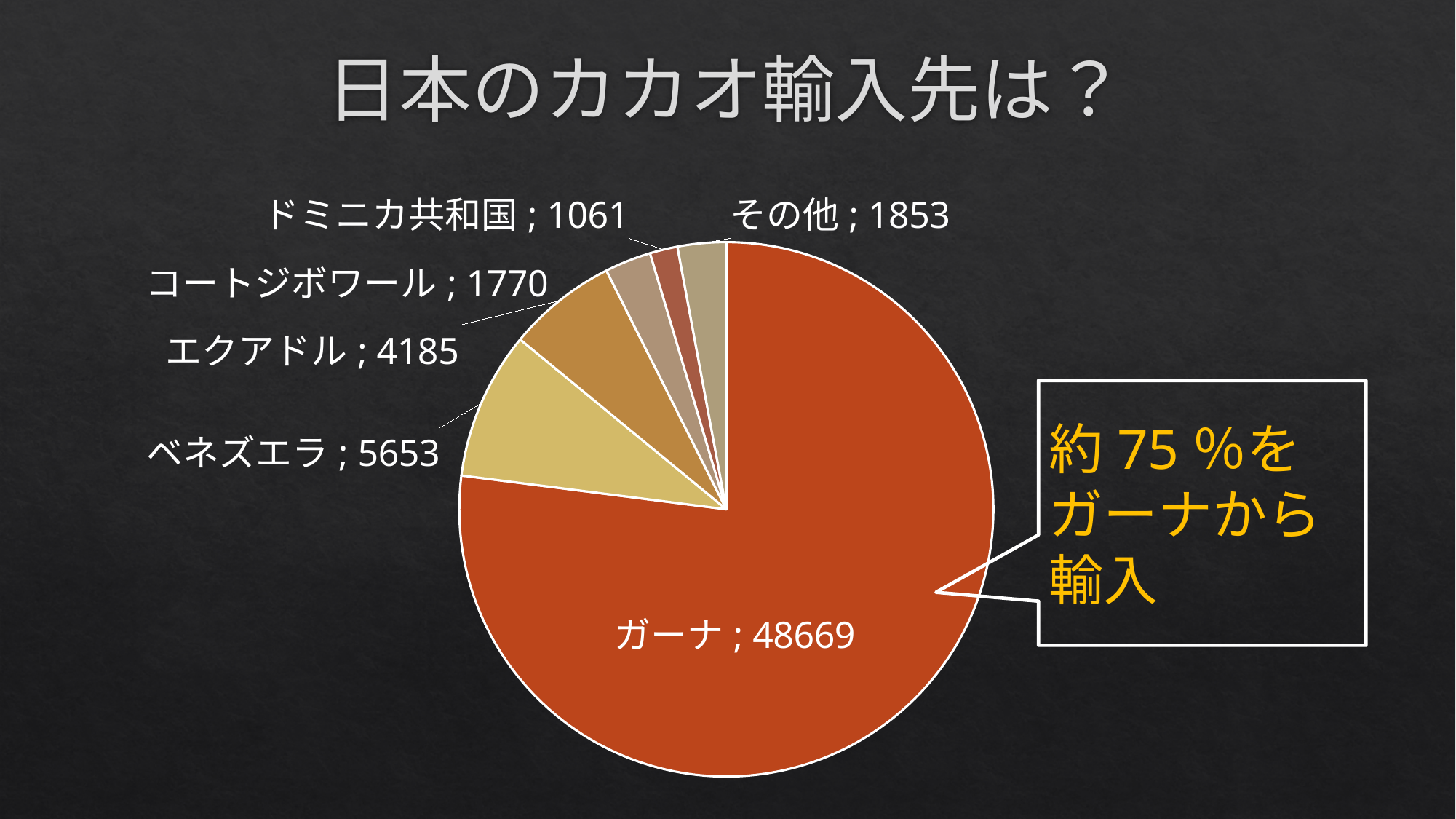
What is the value shown for ガーナ in the pie chart? 48669 What is the value shown for エクアドル? 4185 How many slices does the pie chart have? 6 Which category has the smallest slice of the pie? ドミニカ共和国 What is the title of the slide? 日本のカカオ輸入先は？ Which is larger, the value for コートジボワール or the value for その他? その他 What is the difference between the values for ベネズエラ and エクアドル? 1468 What is the value shown for ベネズエラ? 5653 What is the difference between the values for ガーナ and ベネズエラ? 43016 What kind of chart is shown on the slide? Pie chart Which category has the largest slice of the pie? ガーナ What is the value shown for その他? 1853